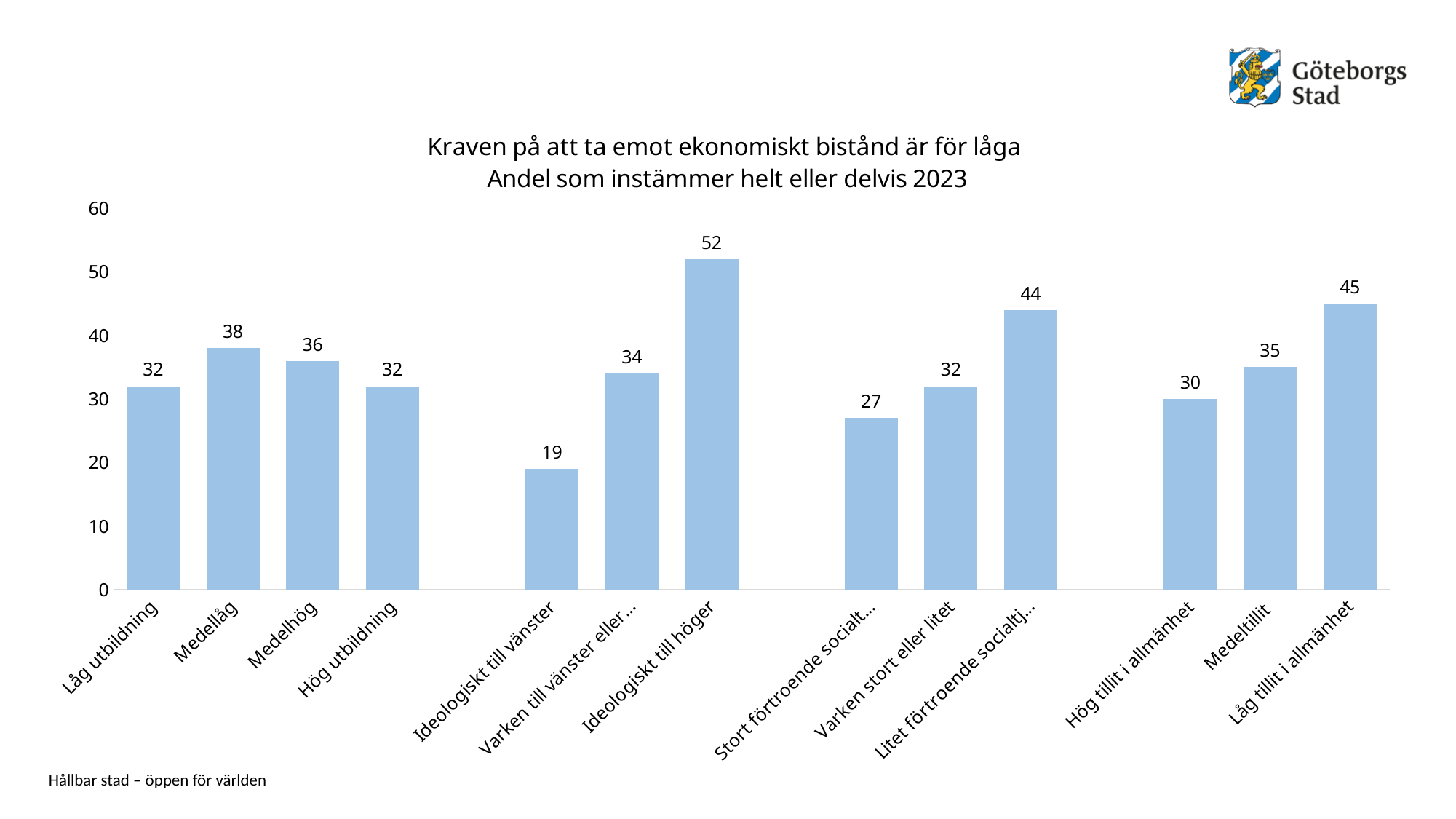
How many bars are shown in the chart? 13 What is the value for Ideologiskt till höger? 52 What is the value for Medellåg? 38 Which category has the lowest value? Ideologiskt till vänster What is the value for Låg tillit i allmänhet? 45 What is the difference between the values for Låg tillit i allmänhet and Medeltillit? 10 What is the difference between the values for Ideologiskt till höger and Ideologiskt till vänster? 33 Which category has the highest value? Ideologiskt till höger What is the value for Hög tillit i allmänhet? 30 What kind of chart is shown on the slide? Bar chart Which is larger, the value for Medelhög or the value for Hög utbildning? Medelhög What is the first line of the chart title? Kraven på att ta emot ekonomiskt bistånd är för låga